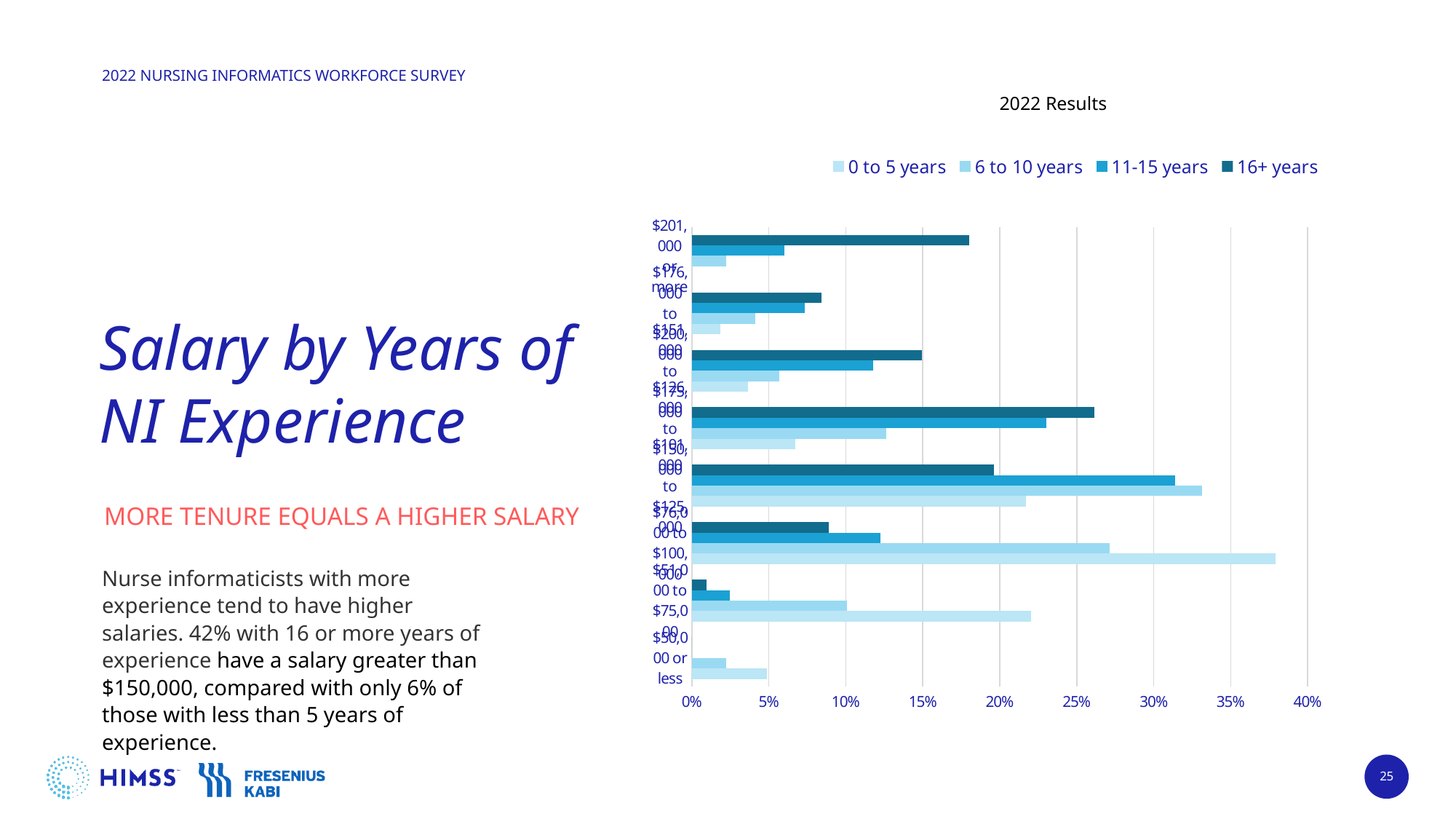
What kind of chart is shown on the slide? Bar chart What is the title of the chart? 2022 Results Is the value for 0 to 5 years in the $76,000 to $100,000 category greater or less than 35%? greater Is the value for 6 to 10 years in the $101,000 to $125,000 category greater or less than 30%? greater How many salary categories are plotted on the chart? 8 Which series does the darkest blue colour represent in the chart legend? 16+ years How many series does the chart legend list? 4 Which series has the highest value in the $76,000 to $100,000 category? 0 to 5 years Is the value for 16+ years in the $201,000 or more category greater or less than 15%? greater In the $201,000 or more category, which is larger: the value for 16+ years or the value for 0 to 5 years? 16+ years For the 16+ years series, which salary category has the highest value? $126,000 to $150,000